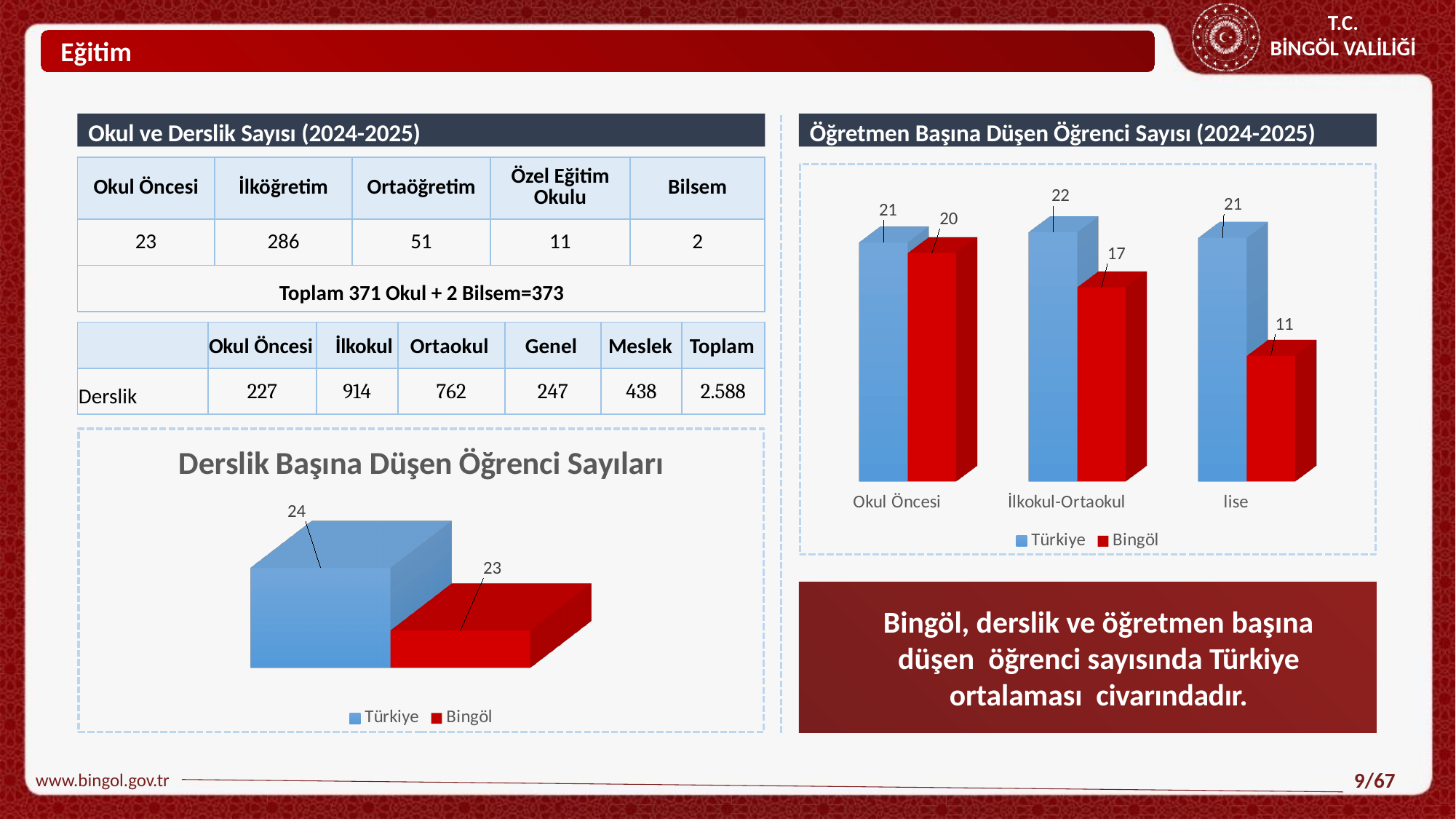
In the chart titled "Derslik Başına Düşen Öğrenci Sayıları", what is the value for Türkiye? 24 In the chart titled "Öğretmen Başına Düşen Öğrenci Sayısı (2024-2025)", which category has the lowest Bingöl value? lise In the chart titled "Derslik Başına Düşen Öğrenci Sayıları", what is the value for Bingöl? 23 In the chart titled "Öğretmen Başına Düşen Öğrenci Sayısı (2024-2025)", what is the difference between the Türkiye and Bingöl values for lise? 10 In the chart titled "Öğretmen Başına Düşen Öğrenci Sayısı (2024-2025)", what is the Bingöl value for lise? 11 In the chart titled "Öğretmen Başına Düşen Öğrenci Sayısı (2024-2025)", which category has the highest Türkiye value? İlkokul-Ortaokul What kind of chart is the one titled "Öğretmen Başına Düşen Öğrenci Sayısı (2024-2025)"? Bar chart In the chart titled "Öğretmen Başına Düşen Öğrenci Sayısı (2024-2025)", how many categories are shown on the x axis? 3 In the chart titled "Derslik Başına Düşen Öğrenci Sayıları", how many series does the legend list? 2 In the chart titled "Öğretmen Başına Düşen Öğrenci Sayısı (2024-2025)", what is the Türkiye value for İlkokul-Ortaokul? 22 In the chart titled "Öğretmen Başına Düşen Öğrenci Sayısı (2024-2025)", what is the Bingöl value for Okul Öncesi? 20 In the chart titled "Derslik Başına Düşen Öğrenci Sayıları", what is the difference between the Türkiye and Bingöl values? 1